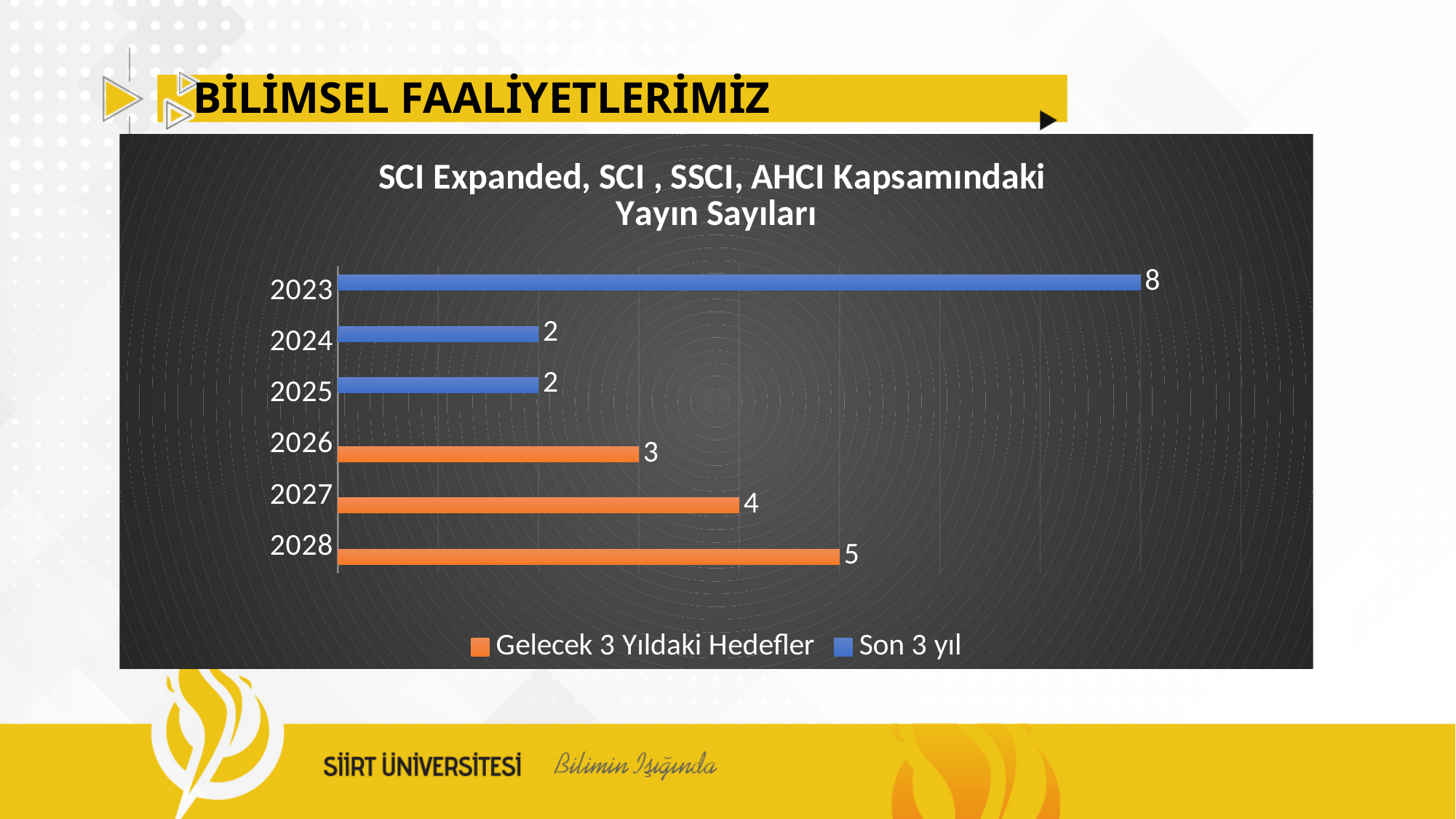
What kind of chart is shown on the slide? Bar chart What is the value for 2028 in the 'Gelecek 3 Yıldaki Hedefler' series? 5 How many years are shown on the chart? 6 How many series does the legend list? 2 Which year has the highest value in the 'Gelecek 3 Yıldaki Hedefler' series? 2028 Which year has the highest value on the chart? 2023 Do the values in the 'Gelecek 3 Yıldaki Hedefler' series rise or fall from 2026 to 2028? Rise What is the difference between the values for 2028 and 2026? 2 What is the difference between the values for 2023 and 2024? 6 What is the value for 2023 in the 'Son 3 yıl' series? 8 What is the value for 2026? 3 Which is larger, the value for 2027 or the value for 2025? 2027